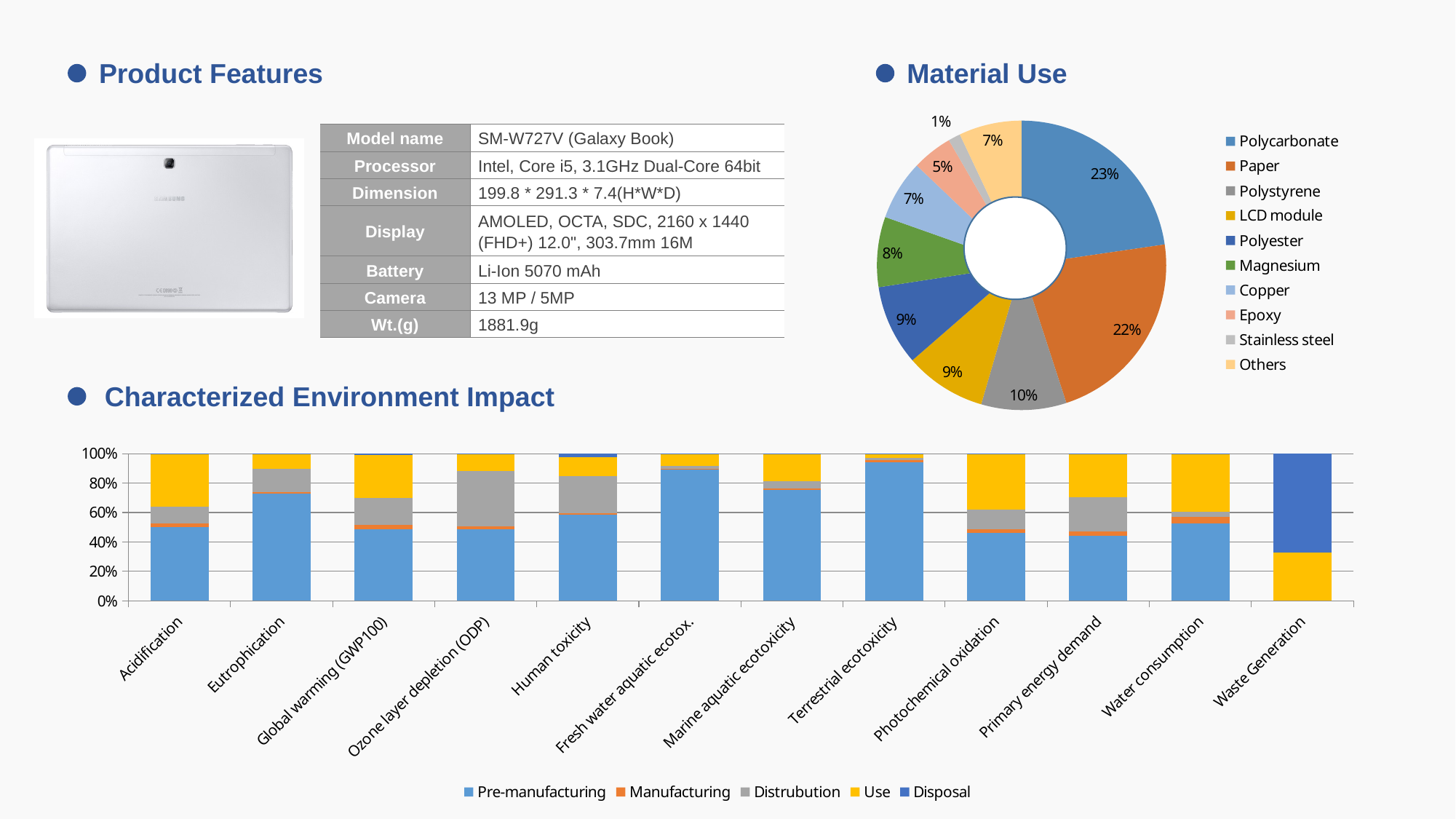
In the Characterized Environment Impact chart, is the Use share for Waste Generation greater or less than 40%? less How many impact categories are shown on the x axis of the Characterized Environment Impact chart? 12 In the Material Use chart, which material has the largest share? Polycarbonate In the Material Use chart, how many materials does the legend list? 10 In the Characterized Environment Impact chart, is the Pre-manufacturing share for Terrestrial ecotoxicity greater or less than 80%? greater How many series does the legend of the Characterized Environment Impact chart list? 5 In the Material Use chart, what share of material is Polystyrene? 10% What kind of chart is the Characterized Environment Impact chart? Stacked bar chart In the Material Use chart, what share of material is Paper? 22% In the Material Use chart, what is the difference between the Magnesium share and the Epoxy share? 3% In the Material Use chart, which material has the smallest share? Stainless steel In the Material Use chart, what share of material is Polycarbonate? 23%